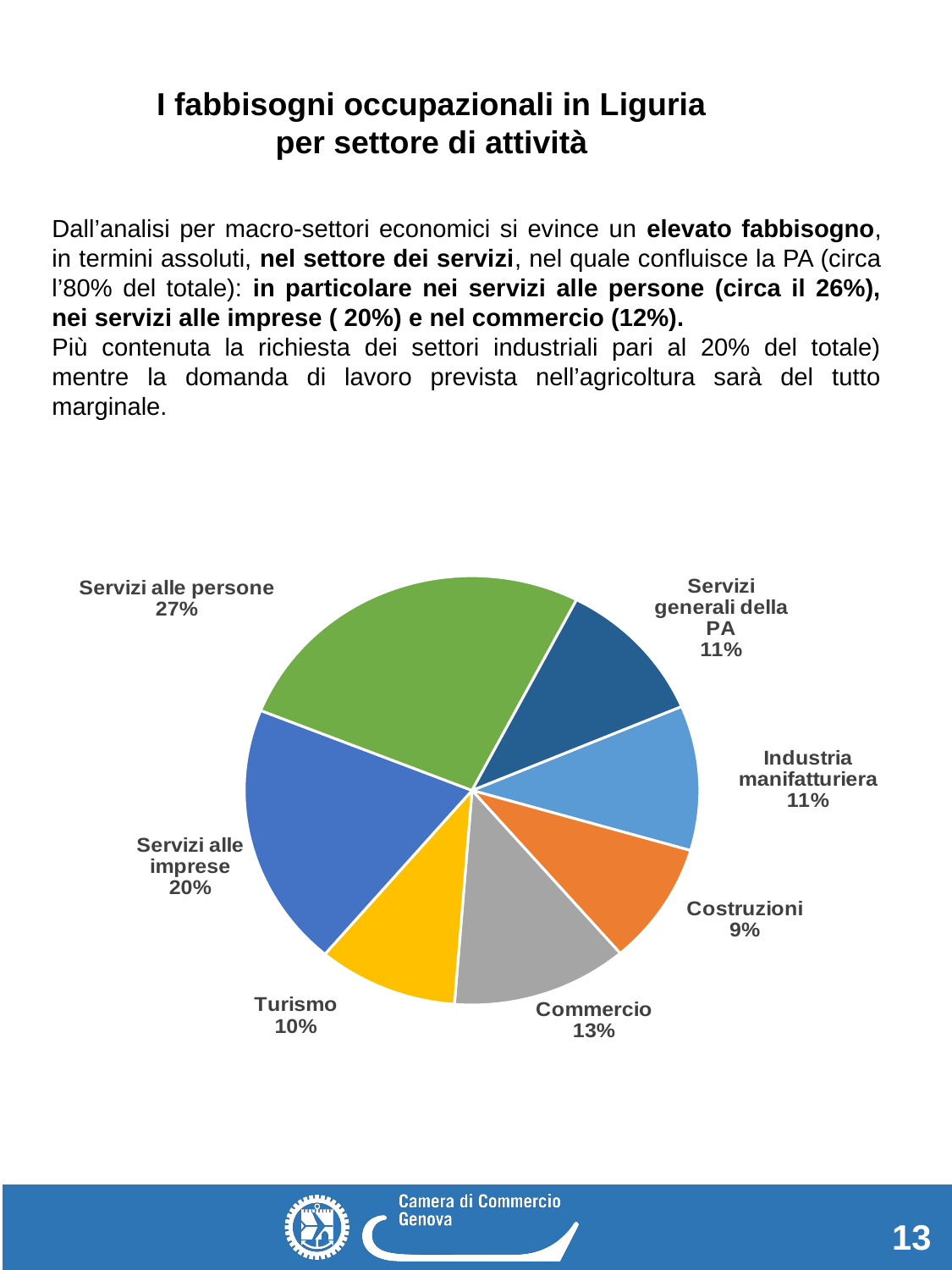
What is the value shown for Servizi alle imprese? 20% How many sectors are shown in the pie chart? 7 Which is larger, the share for Commercio or the share for Turismo? Commercio What colour is the slice for Turismo? Yellow What is the value shown for Costruzioni? 9% Which sector has the smallest slice of the pie? Costruzioni Which sector has the largest slice of the pie? Servizi alle persone What share of the pie does Servizi alle persone have? 27% What is the difference between the shares of Servizi alle persone and Servizi alle imprese? 7% What is the difference between the shares of Commercio and Costruzioni? 4% What kind of chart is shown on the slide? Pie chart What is the value shown for Commercio? 13%